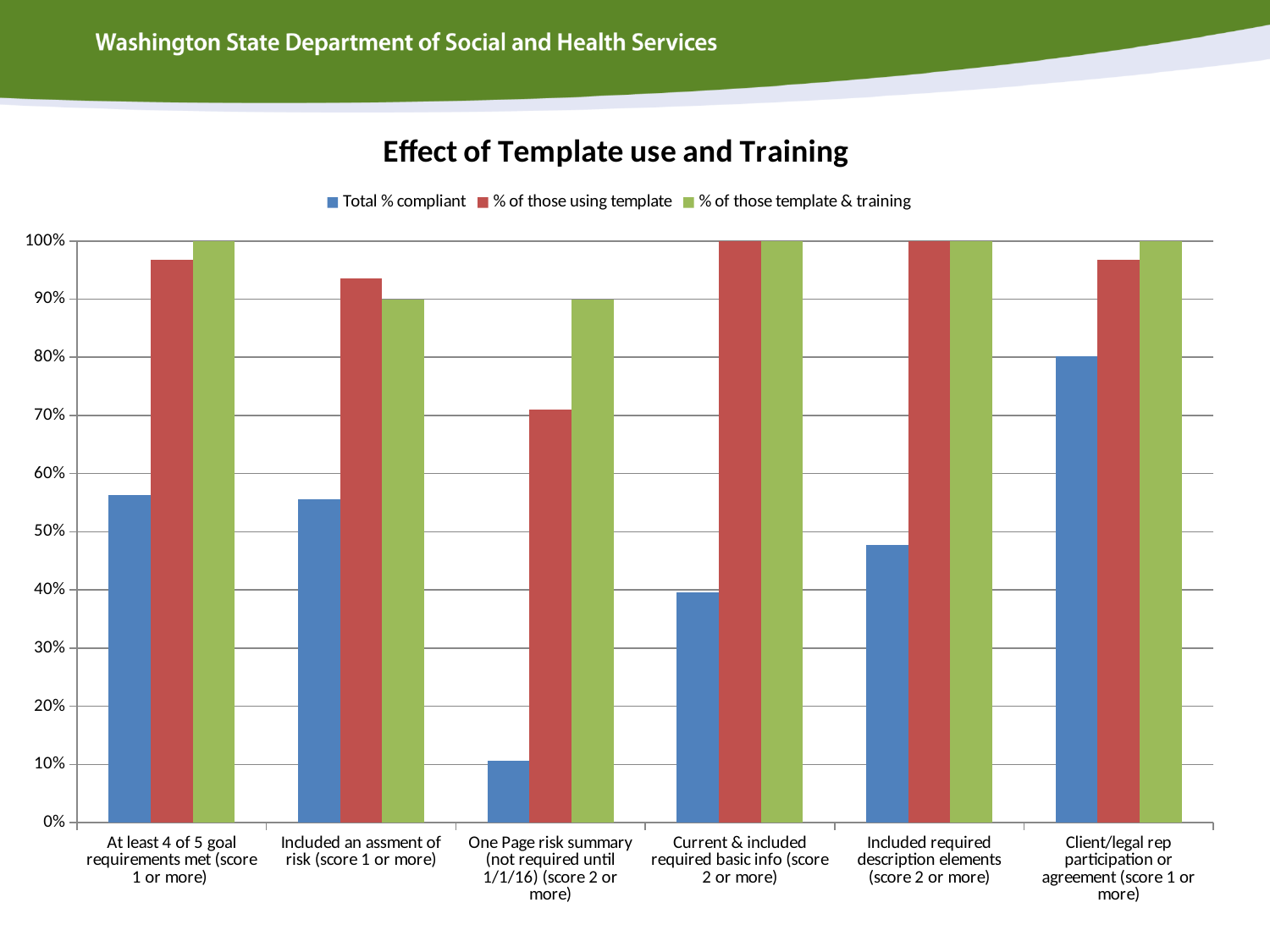
What is the value of 'Total % compliant' for 'Client/legal rep participation or agreement (score 1 or more)'? 80% Which category has the highest 'Total % compliant' value? Client/legal rep participation or agreement (score 1 or more) What is the value of '% of those using template' for 'Included required description elements (score 2 or more)'? 100% Is the 'Total % compliant' value for 'Included required description elements (score 2 or more)' greater or less than 50%? less Which is larger for 'One Page risk summary (not required until 1/1/16) (score 2 or more)': '% of those using template' or '% of those template & training'? % of those template & training What type of chart is shown on the slide? bar chart How many categories are shown on the x axis? 6 What is the value of '% of those template & training' for 'Included an assment of risk (score 1 or more)'? 90% What is the title of the chart? Effect of Template use and Training Which category has the lowest 'Total % compliant' value? One Page risk summary (not required until 1/1/16) (score 2 or more) How many series does the legend list? 3 What is the value of '% of those template & training' for 'Client/legal rep participation or agreement (score 1 or more)'? 100%